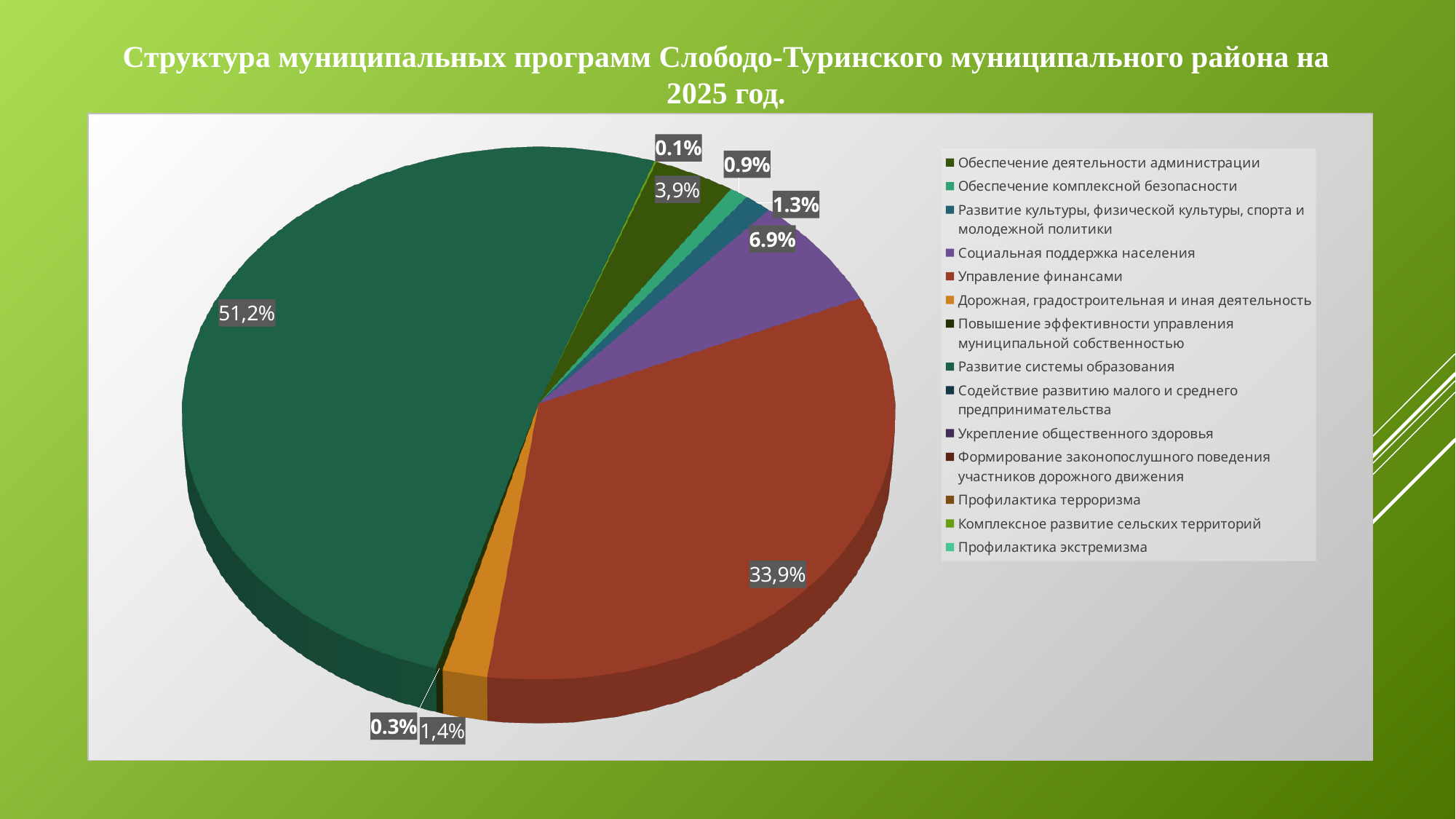
How many entries does the legend list? 14 Which category has the largest share of the pie? Развитие системы образования What share of the pie does Управление финансами have? 33,9% What kind of chart is shown on the slide? pie chart What is the value shown for Дорожная, градостроительная и иная деятельность? 1,4% What is the value shown for Обеспечение деятельности администрации? 3,9% What share of the pie does Развитие системы образования have? 51,2% What is the difference between the shares of Развитие системы образования and Управление финансами? 17,3% What is the value shown for Развитие культуры, физической культуры, спорта и молодежной политики? 1.3% What is the smallest percentage labelled on the pie? 0.1% What is the value shown for Социальная поддержка населения? 6.9% Which is larger: the share for Социальная поддержка населения or for Обеспечение деятельности администрации? Социальная поддержка населения